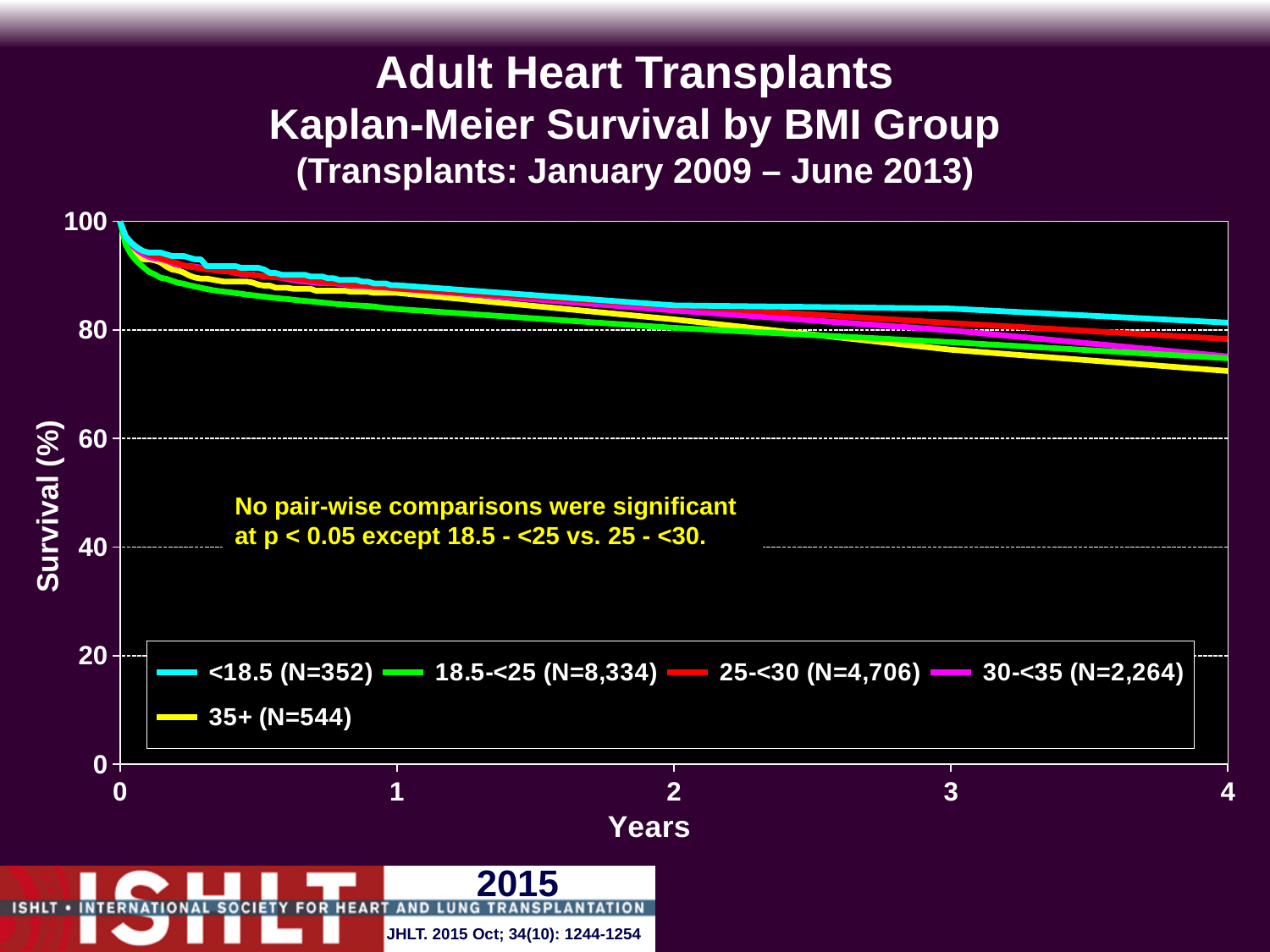
What is the label of the y axis? Survival (%) Which BMI group has the highest survival at 4 years? <18.5 What is the N for the 18.5-<25 BMI group shown in the legend? 8,334 How many BMI groups (series) does the legend list? 5 Do the survival curves rise or fall as years increase? fall Is the survival for the 35+ group at 4 years greater or less than 80%? less Which BMI group has the largest N in the legend? 18.5-<25 (N=8,334) What is the N for the <18.5 BMI group shown in the legend? 352 Which BMI group has the smallest N in the legend? <18.5 (N=352) What kind of chart is shown on the slide? line chart What is the N for the 35+ BMI group shown in the legend? 544 Which BMI group has the lowest survival at 4 years? 35+